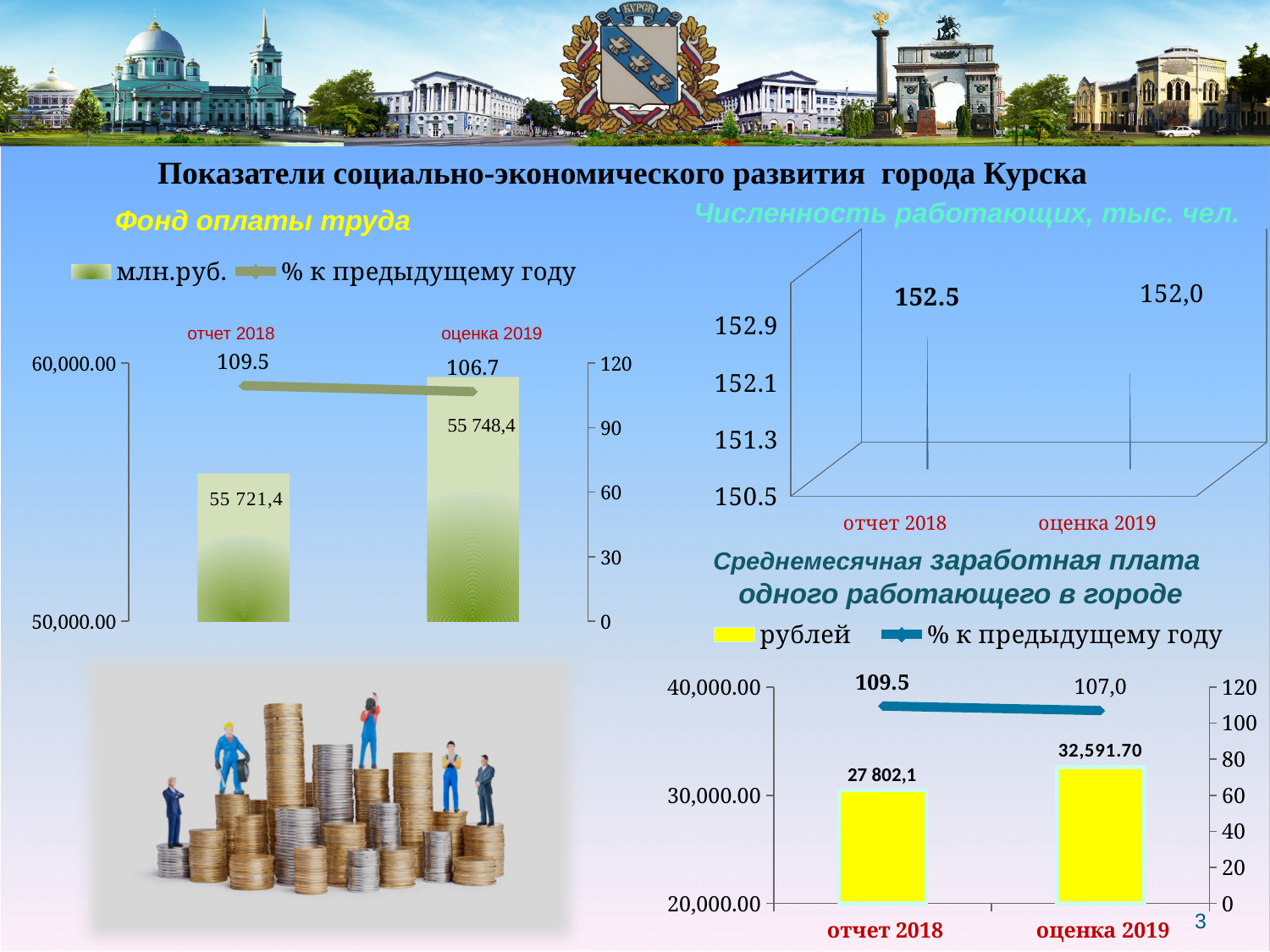
In the 'Фонд оплаты труда' chart, what is the value in млн.руб. for отчет 2018? 55 721,4 In the 'Фонд оплаты труда' chart, what is the '% к предыдущему году' value for отчет 2018? 109.5 In the 'Среднемесячная заработная плата одного работающего в городе' chart, what is the value in рублей for оценка 2019? 32,591.70 In the 'Фонд оплаты труда' chart, how many series does the legend list? 2 In the 'Фонд оплаты труда' chart, what is the value in млн.руб. for оценка 2019? 55 748,4 In the 'Среднемесячная заработная плата одного работающего в городе' chart, what is the '% к предыдущему году' value for оценка 2019? 107,0 In the 'Численность работающих, тыс. чел.' chart, what is the value for оценка 2019? 152,0 In the 'Численность работающих, тыс. чел.' chart, what is the value for отчет 2018? 152.5 In the 'Численность работающих, тыс. чел.' chart, which category has the higher value? отчет 2018 In the 'Фонд оплаты труда' chart, what is the difference between the '% к предыдущему году' values for отчет 2018 and оценка 2019? 2.8 In the 'Среднемесячная заработная плата одного работающего в городе' chart, what is the value in рублей for отчет 2018? 27 802,1 In the 'Фонд оплаты труда' chart, does the '% к предыдущему году' line rise or fall from отчет 2018 to оценка 2019? fall